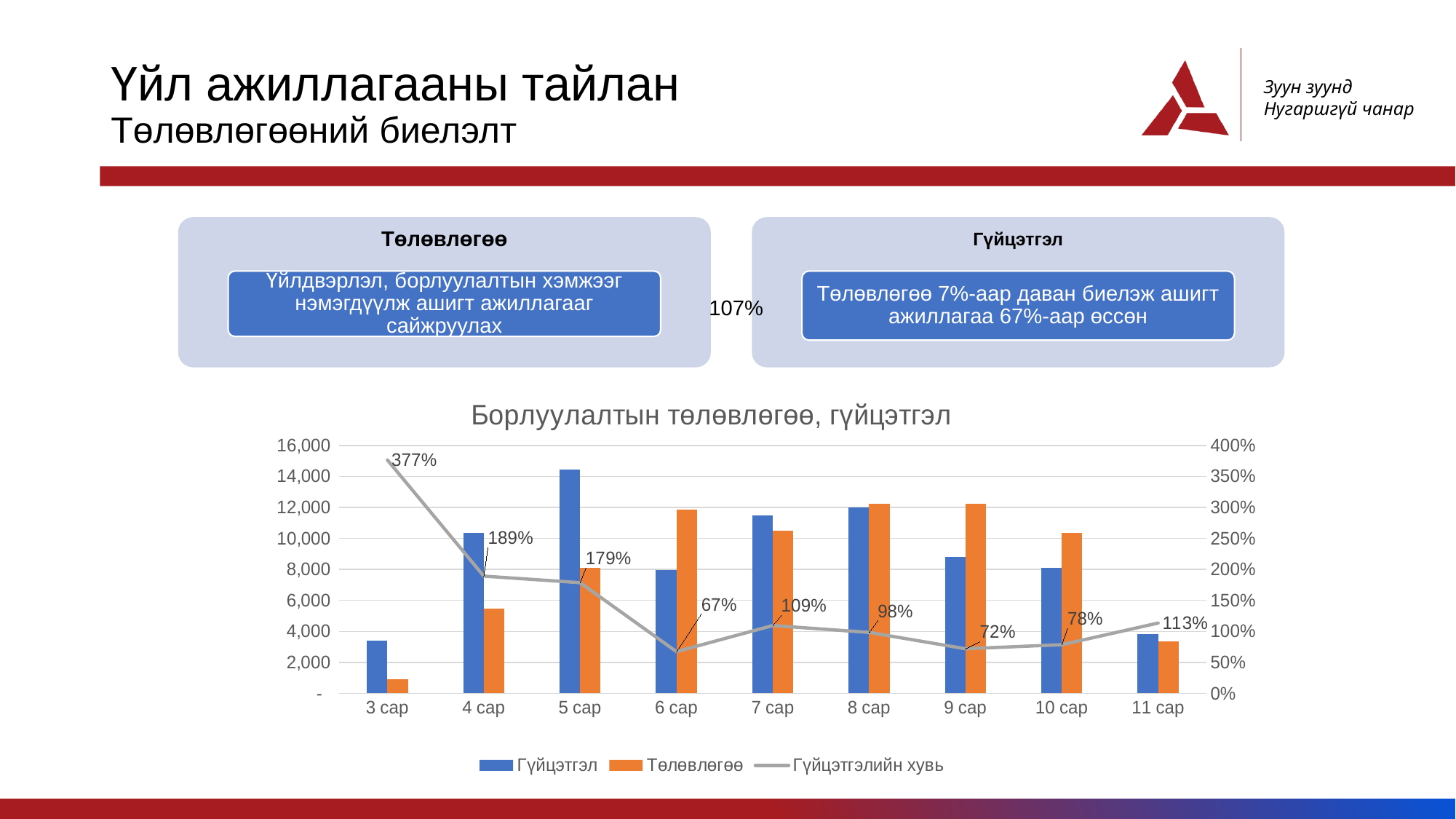
Which month has the highest Гүйцэтгэлийн хувь value? 3 сар Is the Гүйцэтгэл value for 3 сар greater or less than 4,000? less How many series does the chart legend list? 3 For 5 сар, which bar is taller, Гүйцэтгэл or Төлөвлөгөө? Гүйцэтгэл What is the difference between the Гүйцэтгэлийн хувь values for 4 сар and 5 сар? 10% Which month has the larger Гүйцэтгэлийн хувь value, 7 сар or 8 сар? 7 сар Which month has the lowest Гүйцэтгэлийн хувь value? 6 сар What is the Гүйцэтгэлийн хувь value for 11 сар? 113% How many months are shown on the x axis of the chart? 9 What is the Гүйцэтгэлийн хувь value for 3 сар? 377% Is the Төлөвлөгөө value for 6 сар greater or less than 10,000? greater Does the Гүйцэтгэлийн хувь line rise or fall from 3 сар to 6 сар? fall